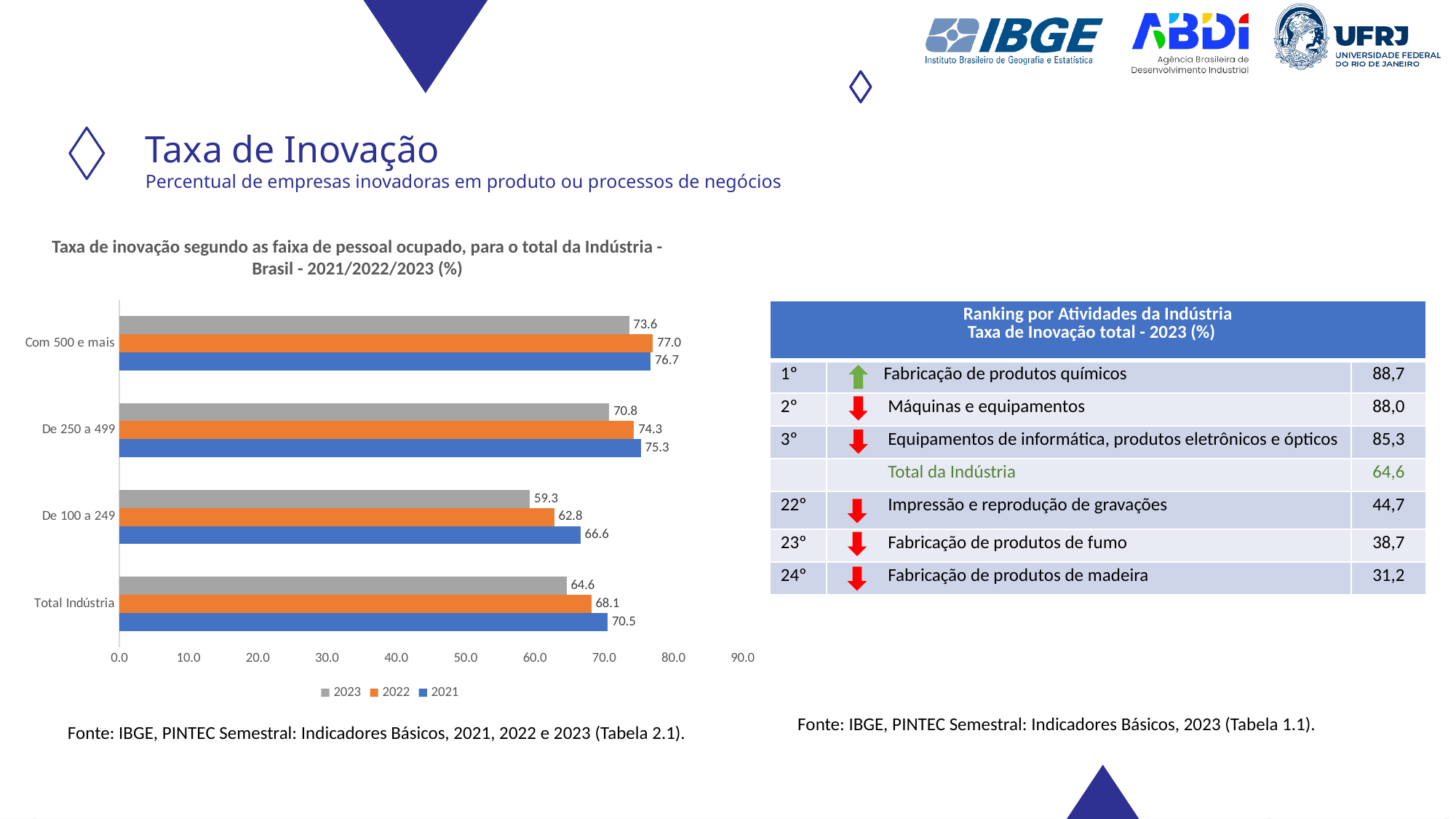
How many categories are shown on the vertical axis of the chart? 4 Is the 2023 value for 'De 100 a 249' greater or less than 60.0? less What kind of chart is shown on the slide? bar chart What is the difference between the 2022 value for 'Com 500 e mais' and the 2022 value for 'Total Indústria'? 8.9 What is the 2021 value for 'De 100 a 249' in the chart? 66.6 Which category has the highest 2022 value in the chart? Com 500 e mais What is the 2023 value for 'Com 500 e mais' in the chart? 73.6 What is the 2022 value for 'Total Indústria' in the chart? 68.1 For 'De 100 a 249', which year has the larger value, 2022 or 2021? 2021 Which category has the lowest 2023 value in the chart? De 100 a 249 For 'Total Indústria', what is the difference between the 2021 value and the 2023 value? 5.9 How many series does the chart legend list? 3